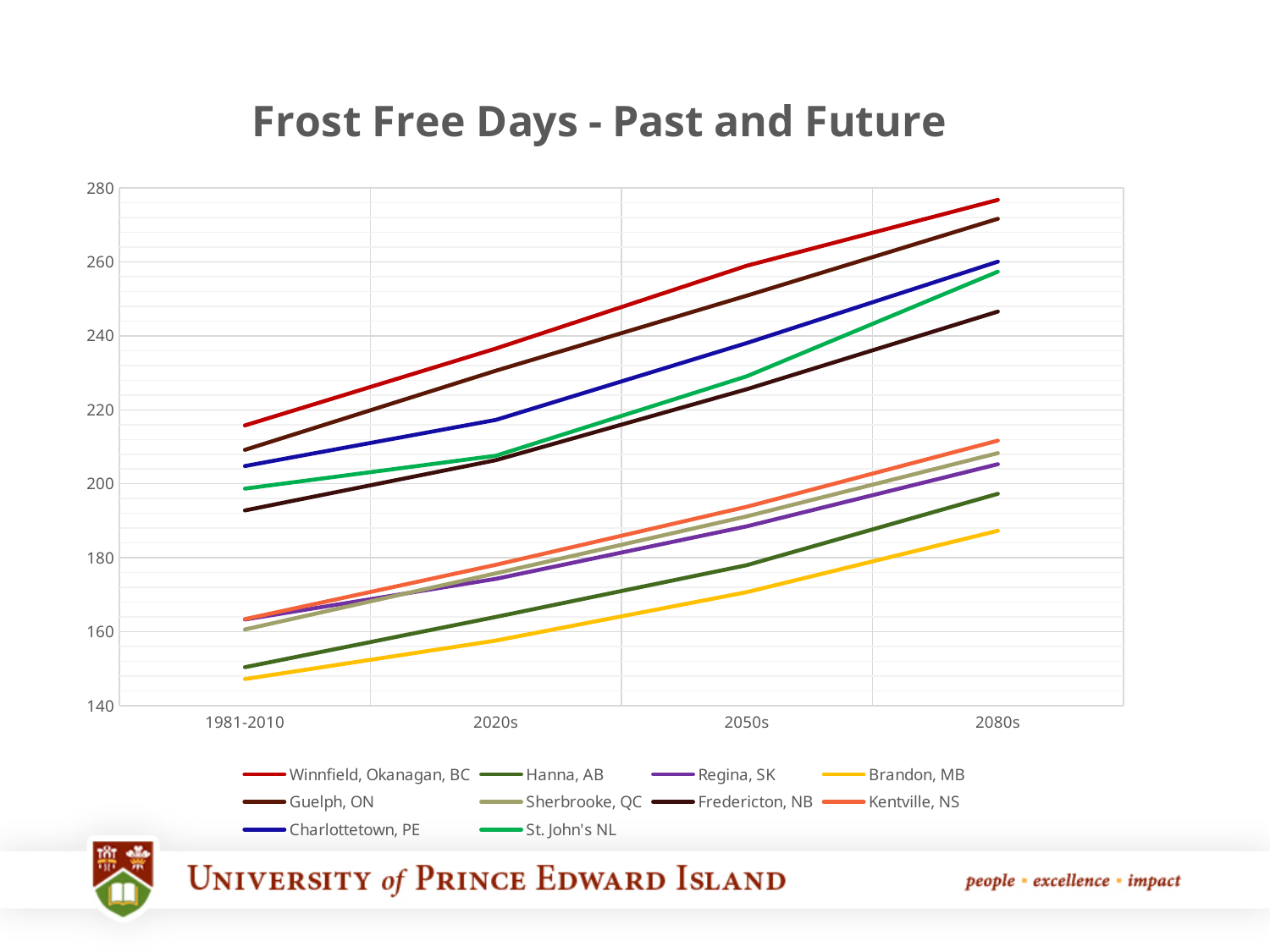
In the 2050s, which has more frost free days: Guelph, ON or Charlottetown, PE? Guelph, ON How many time periods are shown along the x axis? 4 Which location has the lowest number of frost free days in the 2080s? Brandon, MB What is the title of the chart? Frost Free Days - Past and Future Is the value for Winnfield, Okanagan, BC in 1981-2010 greater or less than 200? greater Which location has the highest number of frost free days in the 2080s? Winnfield, Okanagan, BC Is the value for Brandon, MB in 1981-2010 greater or less than 160? less Is the value for Hanna, AB in the 2080s greater or less than 180? greater How many series does the legend list? 10 In the 2080s, which has more frost free days: St. John's NL or Fredericton, NB? St. John's NL Do the frost free days for Brandon, MB rise or fall from 1981-2010 to the 2080s? rise What kind of chart is shown on the slide? line chart